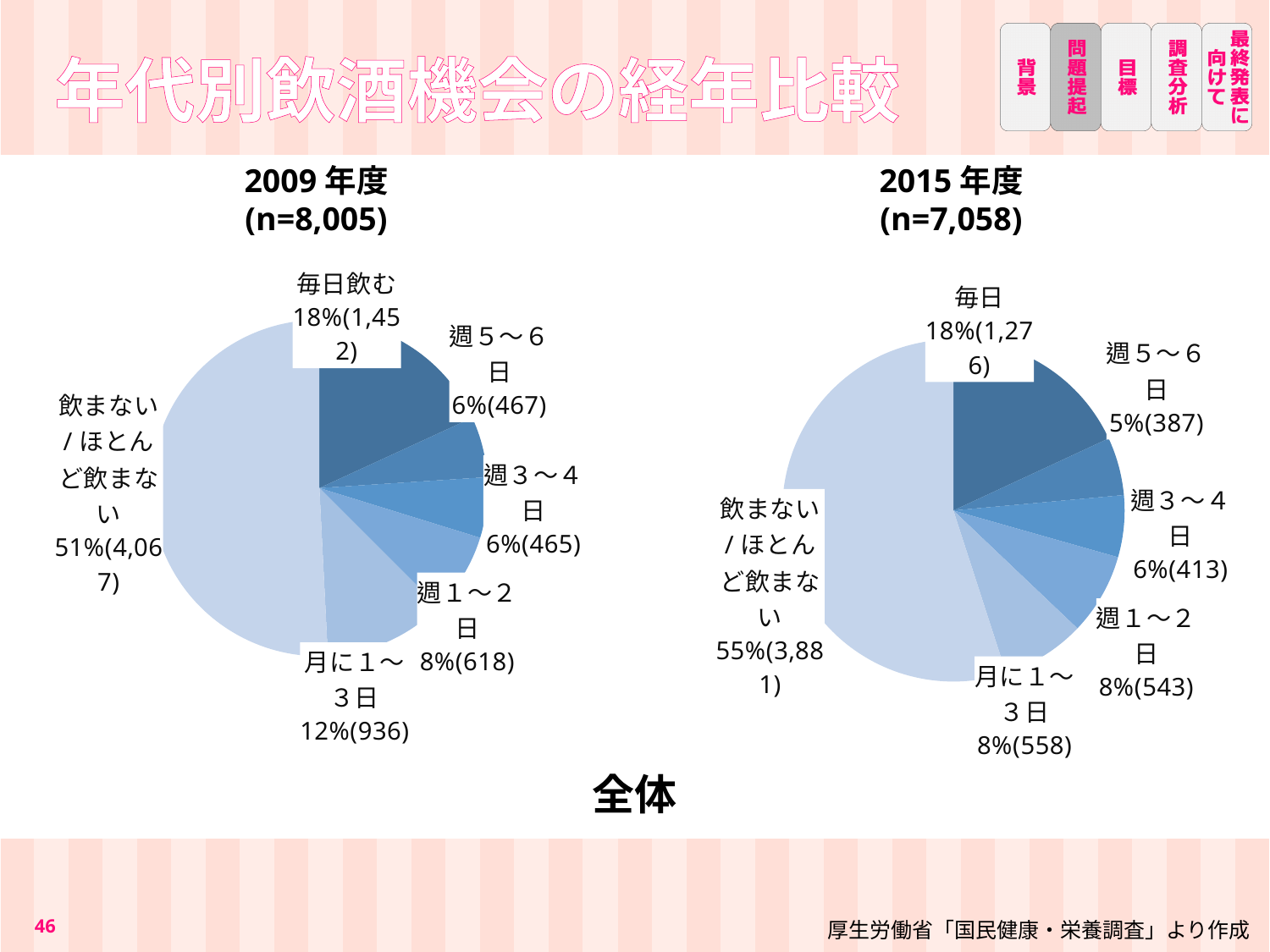
In the 2015年度 pie chart, which category has the smallest share? 週5〜6日 In the 2015年度 pie chart, what count is shown for 週5〜6日? 387 In the 2009年度 pie chart, what is the share for 飲まない/ほとんど飲まない? 51% In the 2009年度 pie chart, what count is shown for 毎日飲む? 1,452 In the 2015年度 pie chart, which category has the largest share? 飲まない/ほとんど飲まない How many categories does each pie chart have? 6 Which is larger: the count for 週1〜2日 in the 2009年度 chart or in the 2015年度 chart? 2009年度 (618) In the 2009年度 pie chart, which category has the smallest count? 週3〜4日 In the 2015年度 pie chart, what is the share for 飲まない/ほとんど飲まない? 55% What type of charts are shown on the slide? Pie charts What is the sample size (n) shown for the 2015年度 chart? n=7,058 What is the difference in count for 月に1〜3日 between the 2009年度 chart (936) and the 2015年度 chart (558)? 378